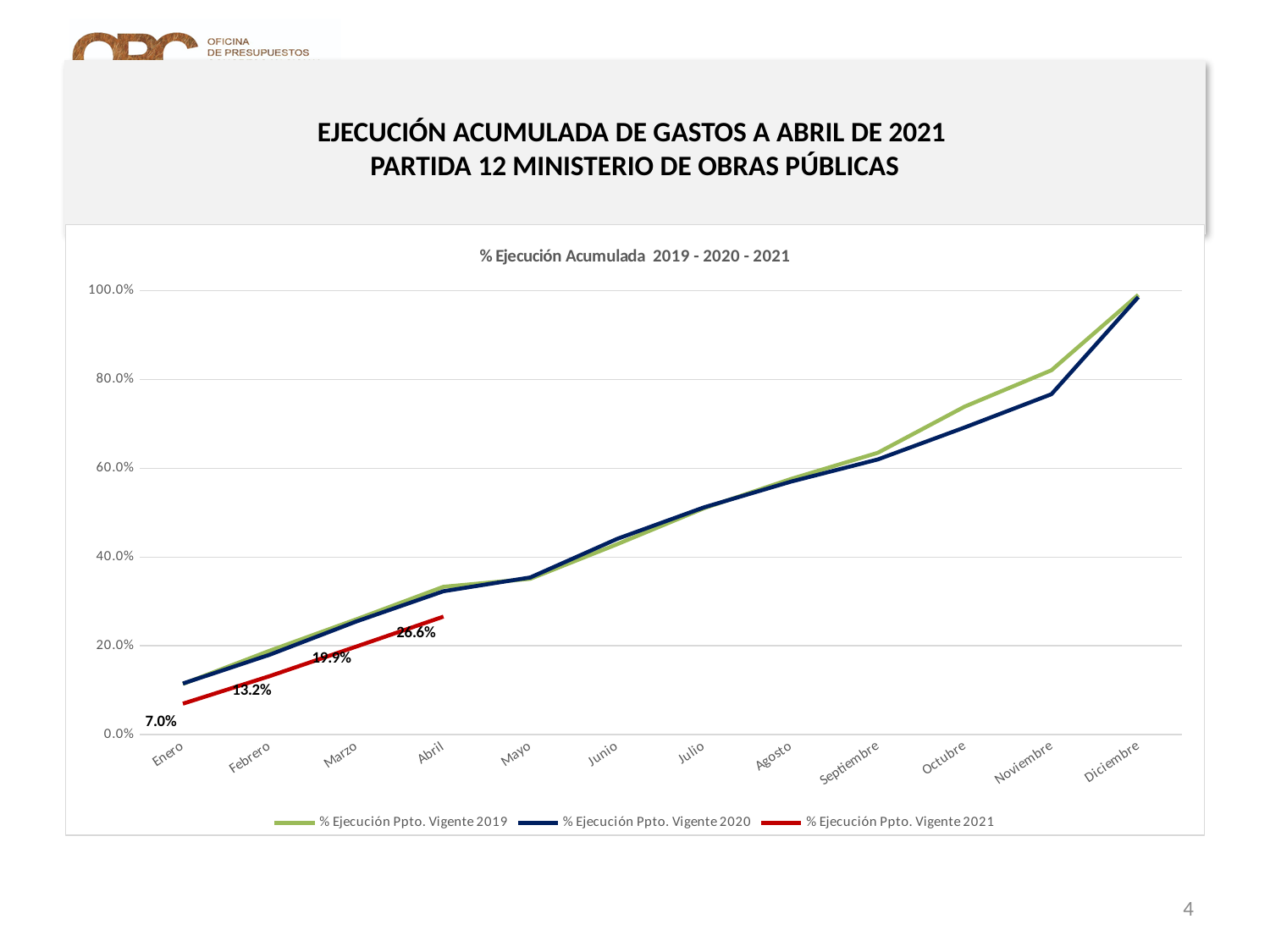
What is the difference between the Marzo and Febrero values of the % Ejecución Ppto. Vigente 2021 series? 6.7% What is the value for Abril in the % Ejecución Ppto. Vigente 2021 series? 26.6% What is the value for Enero in the % Ejecución Ppto. Vigente 2021 series? 7.0% What is the difference between the Abril and Enero values of the % Ejecución Ppto. Vigente 2021 series? 19.6% Is the value for Noviembre in the % Ejecución Ppto. Vigente 2020 series greater or less than 80.0%? less Do the values of the % Ejecución Ppto. Vigente 2019 series rise or fall from Enero to Diciembre? Rise How many series does the legend list? 3 What is the value for Marzo in the % Ejecución Ppto. Vigente 2021 series? 19.9% How many months are shown on the x axis? 12 In Noviembre, which series has the larger value: % Ejecución Ppto. Vigente 2019 or % Ejecución Ppto. Vigente 2020? % Ejecución Ppto. Vigente 2019 Which month has the highest value in the % Ejecución Ppto. Vigente 2021 series? Abril What kind of chart is shown on the slide? Line chart